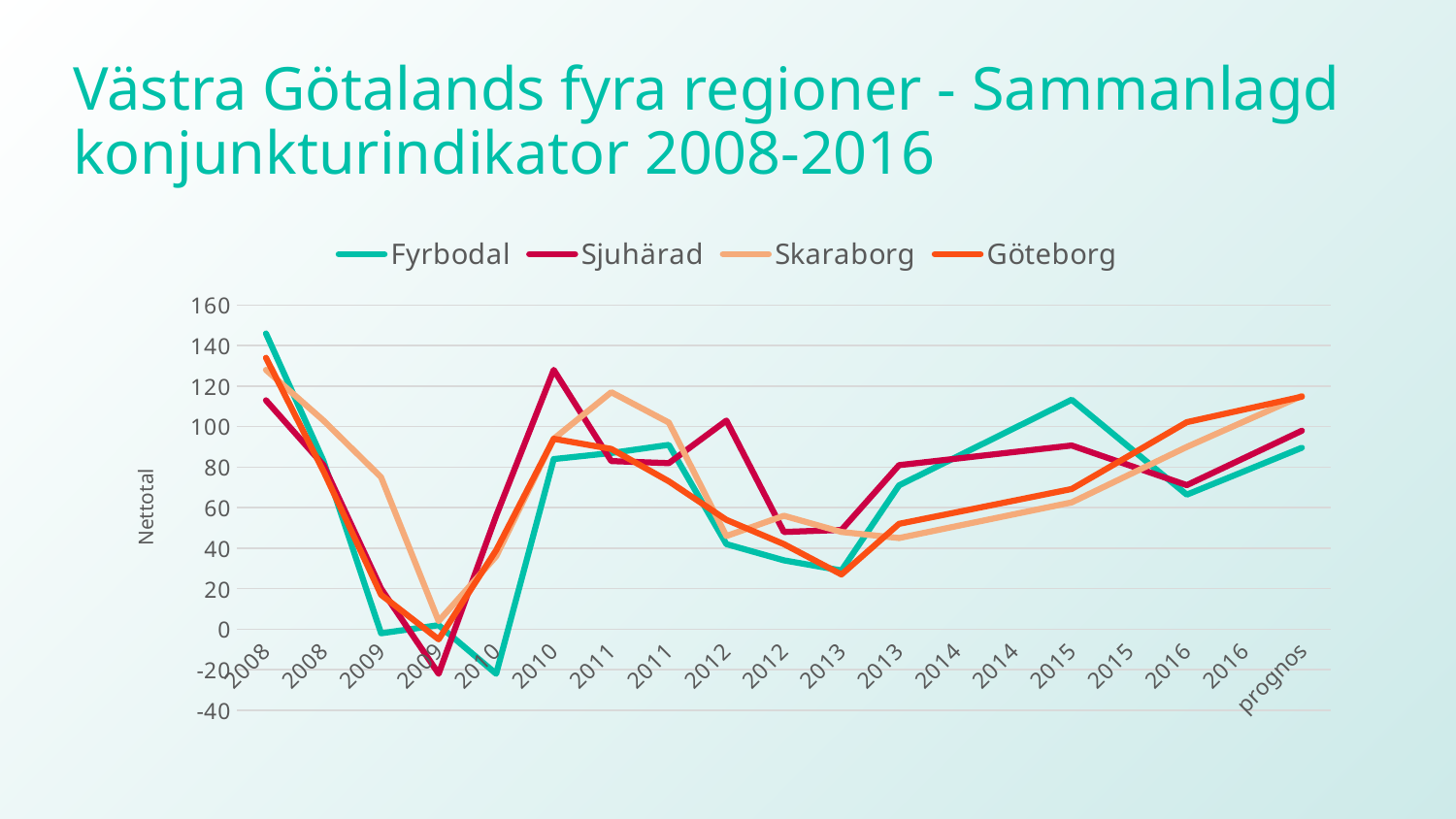
Is the value for Göteborg at the first 2013 point greater or less than 40? less Is the value for Sjuhärad at the first 2008 point greater or less than 120? less At the second 2010 point, which is larger: Sjuhärad or Fyrbodal? Sjuhärad What is the title of the vertical axis? Nettotal Which series is listed first in the legend? Fyrbodal Is the value for Fyrbodal at the first 2008 point greater or less than 140? greater How many points are there along the x axis? 19 How many series does the legend list? 4 What kind of chart is shown on the slide? line chart Which series has the highest value at the first 2008 point? Fyrbodal